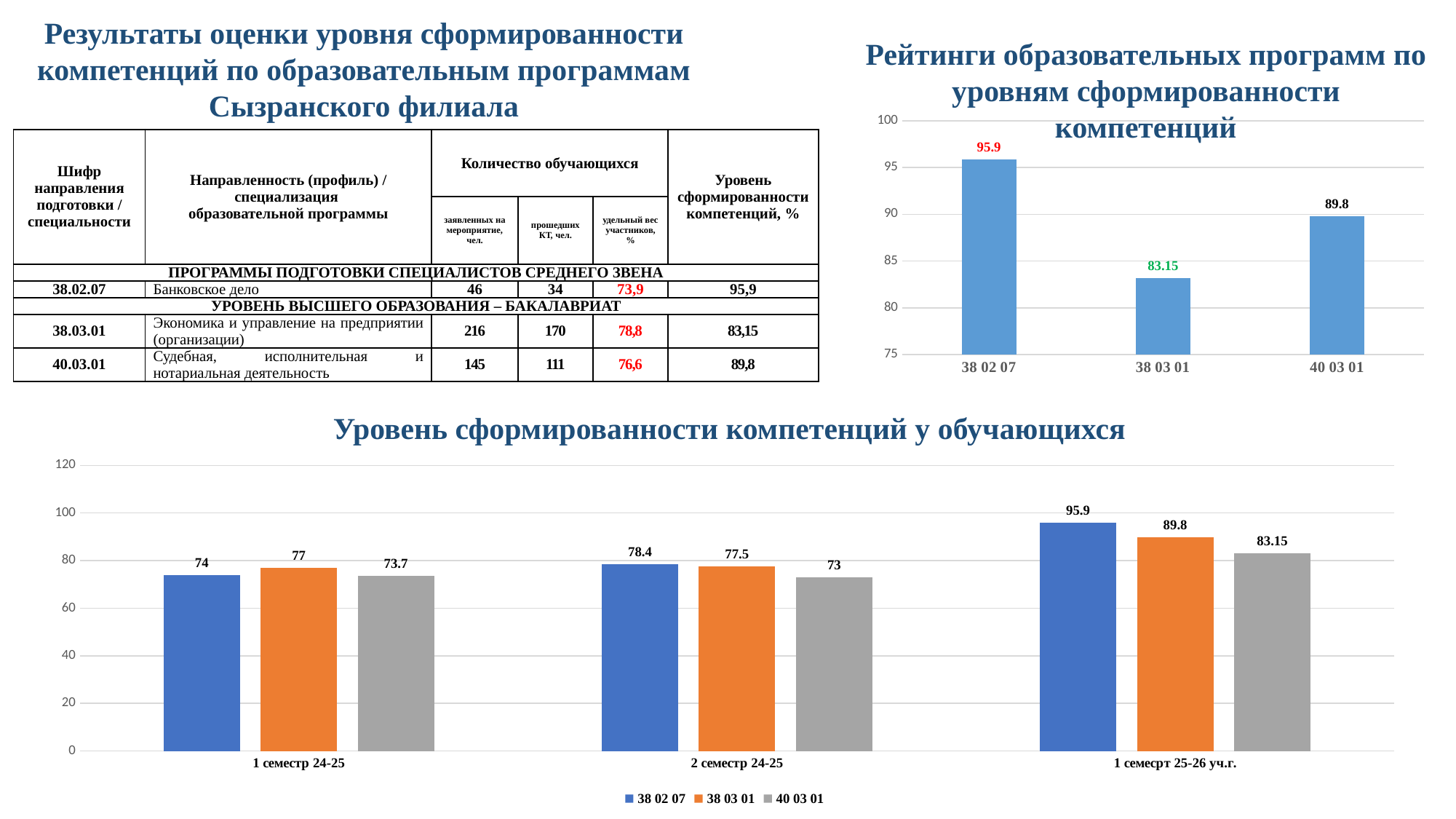
In the chart titled 'Уровень сформированности компетенций у обучающихся', which series has the highest value in '1 семестр 25-26 уч.г.'? 38 02 07 In the chart titled 'Уровень сформированности компетенций у обучающихся', does the value for 38 02 07 rise or fall from '1 семестр 24-25' to '1 семестр 25-26 уч.г.'? rise In the chart titled 'Уровень сформированности компетенций у обучающихся', what is the difference between the 38 02 07 and 38 03 01 values in '1 семестр 25-26 уч.г.'? 6.1 In the chart titled 'Рейтинги образовательных программ по уровням сформированности компетенций', what is the difference between the values for 38 02 07 and 40 03 01? 6.1 In the chart titled 'Уровень сформированности компетенций у обучающихся', is the value for 38 02 07 in '2 семестр 24-25' larger or smaller than the value for 40 03 01 in the same group? larger In the chart titled 'Рейтинги образовательных программ по уровням сформированности компетенций', how many bars are plotted? 3 In the chart titled 'Рейтинги образовательных программ по уровням сформированности компетенций', what is the value for 38 02 07? 95.9 In the chart titled 'Рейтинги образовательных программ по уровням сформированности компетенций', which category has the lowest value? 38 03 01 In the chart titled 'Уровень сформированности компетенций у обучающихся', what is the value for 38 03 01 in '2 семестр 24-25'? 77.5 What type of chart is 'Уровень сформированности компетенций у обучающихся'? bar chart In the chart titled 'Уровень сформированности компетенций у обучающихся', what is the value for 40 03 01 in '1 семестр 24-25'? 73.7 In the chart titled 'Уровень сформированности компетенций у обучающихся', how many series does the legend list? 3